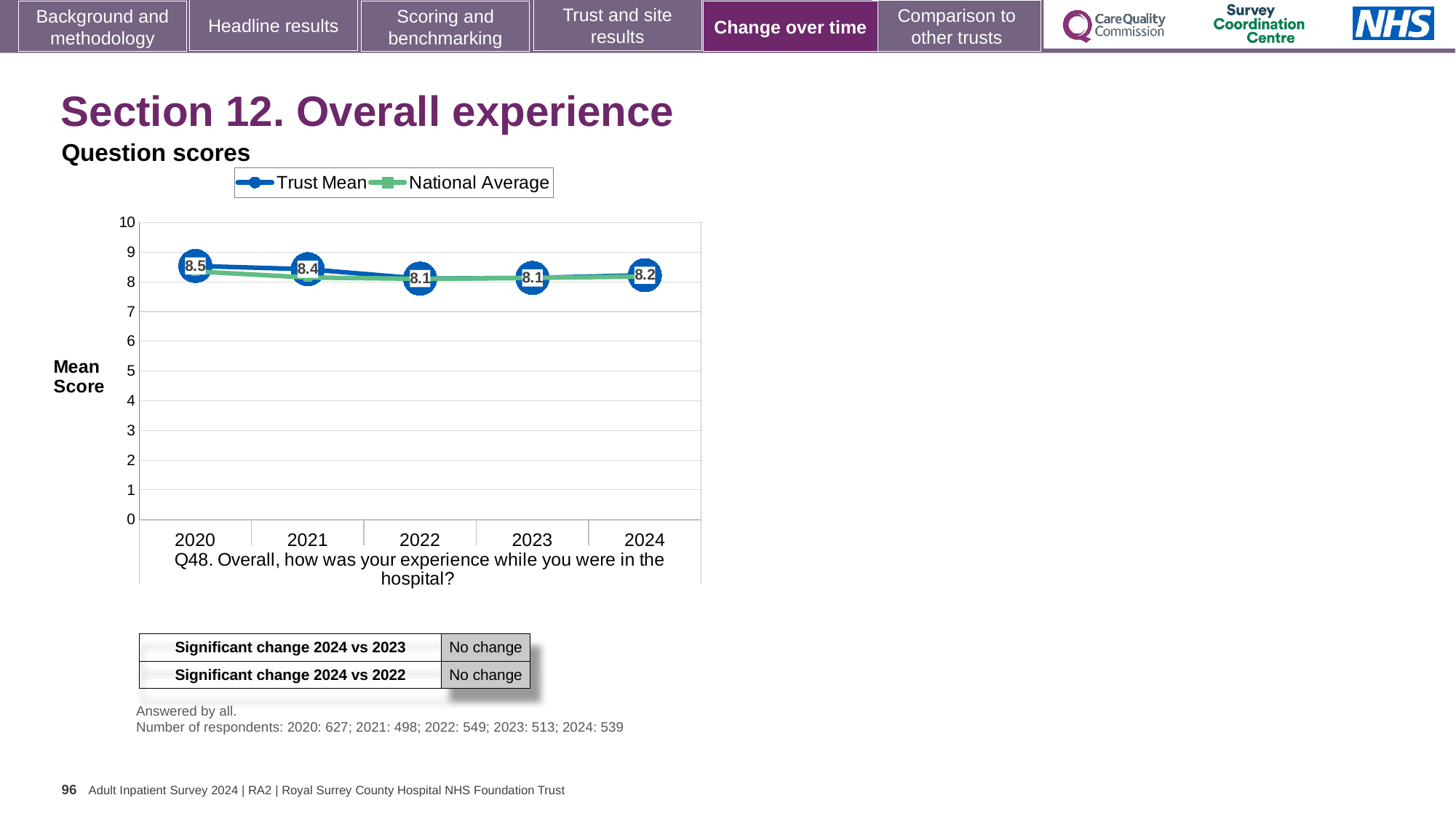
What is the Trust Mean score for 2020? 8.5 Does the Trust Mean score rise or fall from 2020 to 2022? fall Is the National Average value for 2024 greater or less than 7? greater What kind of chart is shown on the slide? line chart What is the Trust Mean score for 2022? 8.1 What is the difference between the Trust Mean scores for 2020 and 2024? 0.3 Is the National Average value for 2020 greater or less than 9? less How many years are plotted on the x axis? 5 In which year is the Trust Mean score highest? 2020 Which is larger, the Trust Mean score for 2021 or for 2023? 2021 What is the Trust Mean score for 2024? 8.2 How many series does the legend list? 2